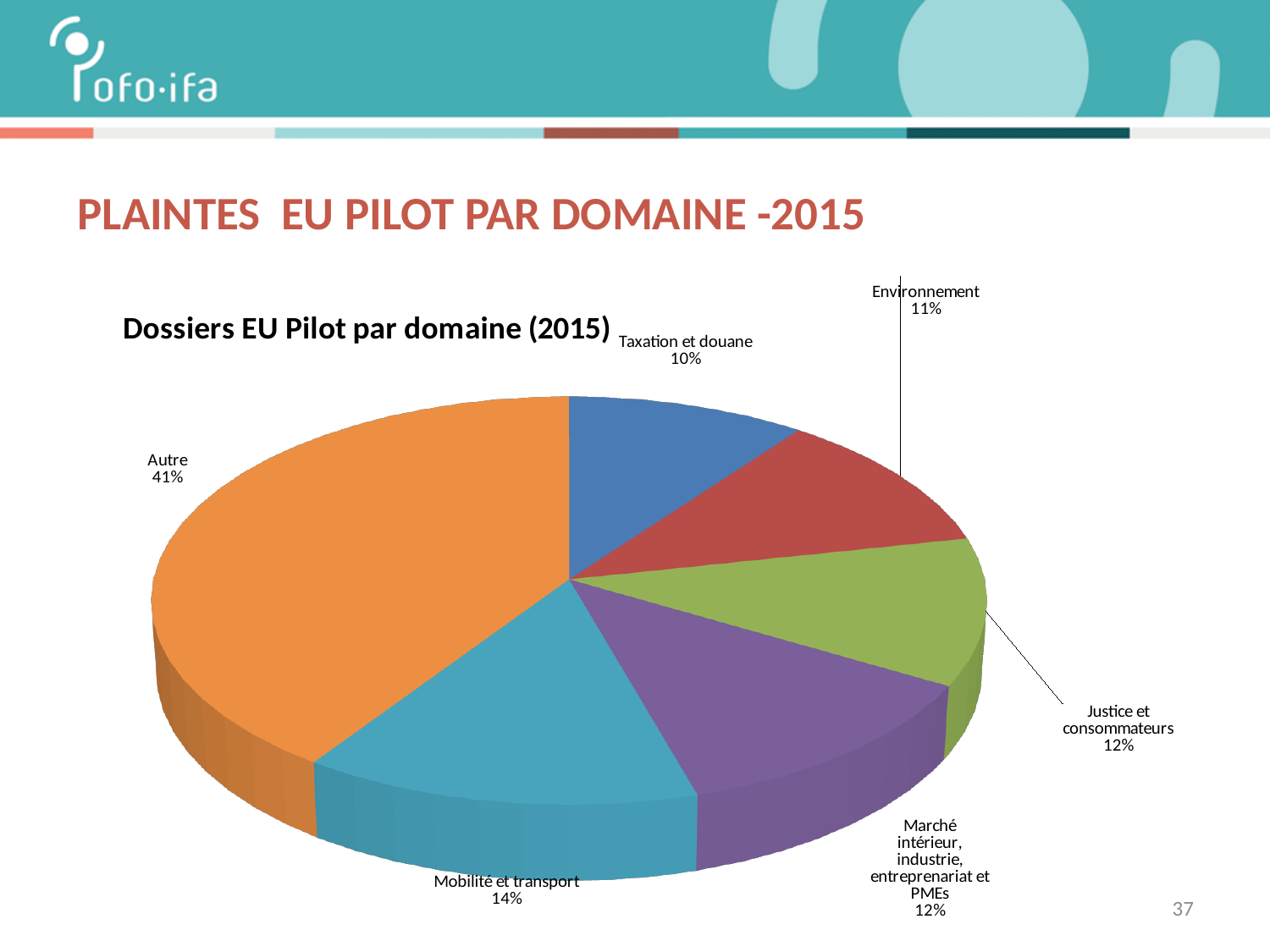
What share of the pie does Autre represent? 41% What percentage is shown for Environnement? 11% What percentage is shown for Taxation et douane? 10% Which is larger, the share for Mobilité et transport or the share for Environnement? Mobilité et transport Which category has the largest share of the pie? Autre What is the difference in percentage points between Autre and Mobilité et transport? 27 Which category has the smallest share of the pie? Taxation et douane What percentage is shown for Justice et consommateurs? 12% What is the title of the chart? Dossiers EU Pilot par domaine (2015) What percentage is shown for Mobilité et transport? 14% How many categories (slices) does the pie chart have? 6 What type of chart is shown on the slide? Pie chart